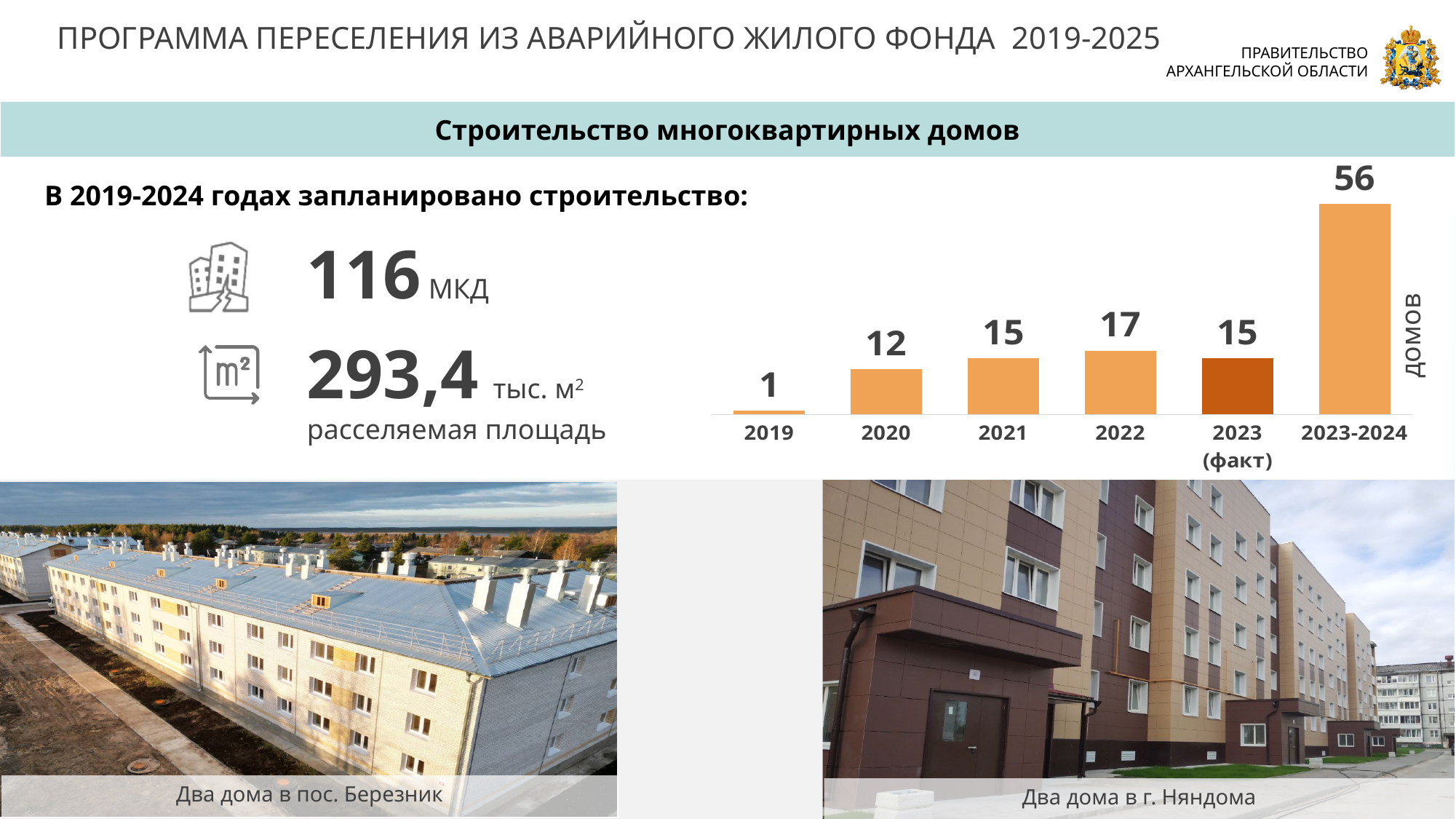
Which is larger, the value for 2020 or the value for 2022? 2022 Which bar in the chart is shown in a darker orange colour than the others? 2023 (факт) What is the value for 2023 (факт) in the bar chart? 15 Which category has the highest value in the bar chart? 2023-2024 Do the values rise or fall from 2019 to 2022 in the bar chart? rise What is the value for 2022 in the bar chart? 17 What is the difference between the values for 2023-2024 and 2022? 39 What kind of chart is shown on the slide? bar chart How many categories are shown on the x axis of the bar chart? 6 What is the value for 2020 in the bar chart? 12 Which category has the lowest value in the bar chart? 2019 What is the difference between the values for 2021 and 2019? 14